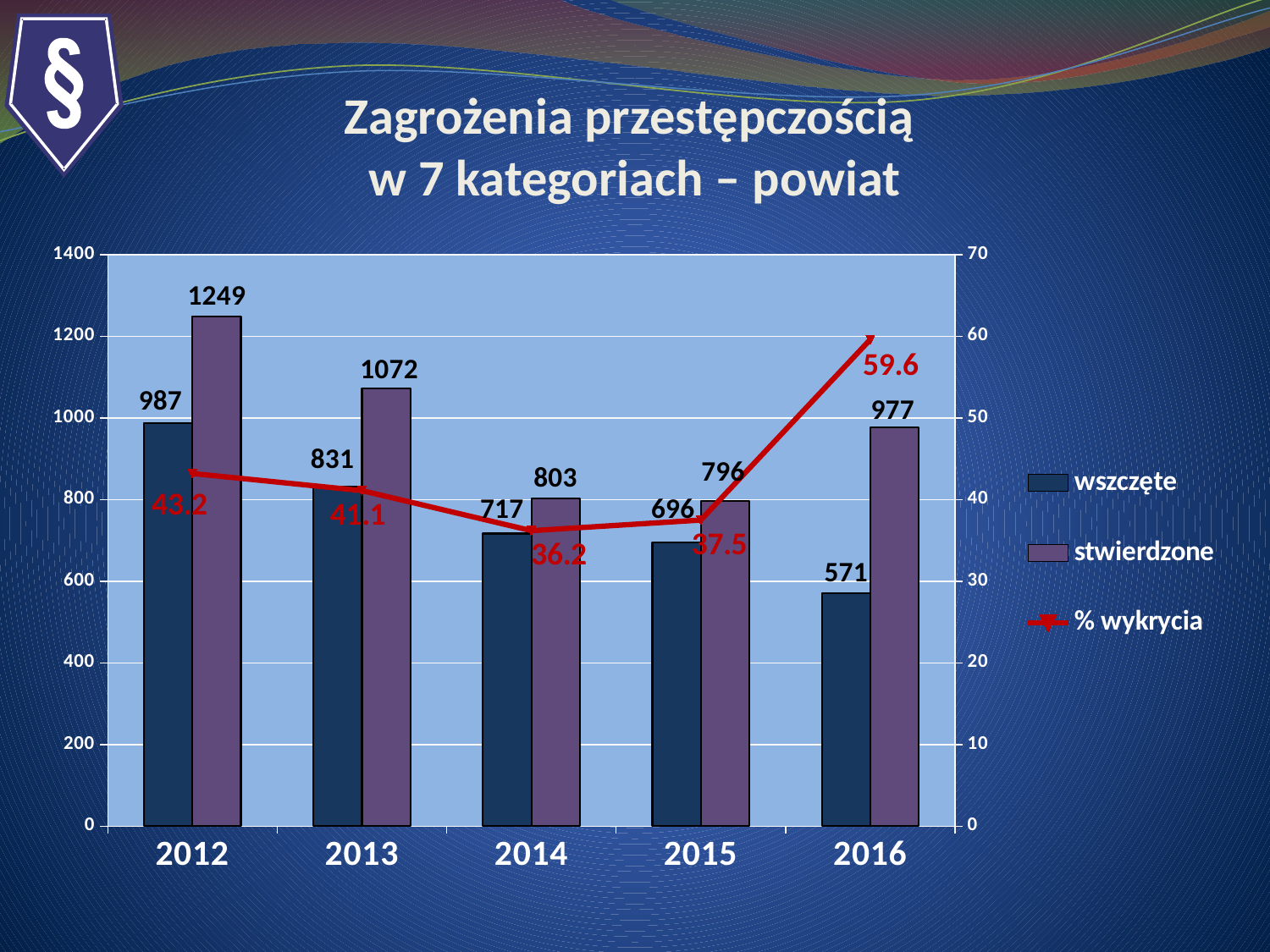
What is the difference between 'stwierdzone' and 'wszczęte' in 2016? 406 What is the value of 'stwierdzone' for 2016? 977 Which is larger in 2013: 'wszczęte' or 'stwierdzone'? stwierdzone What is the value of 'wszczęte' for 2012? 987 In which year is 'stwierdzone' highest? 2012 How many series does the legend list? 3 How many years are shown on the x axis? 5 What is the '% wykrycia' value for 2014? 36.2 Which series is drawn as a red line? % wykrycia Does the 'wszczęte' series rise or fall from 2012 to 2016? fall What kind of chart is this? Combined bar and line chart In which year is 'wszczęte' lowest? 2016